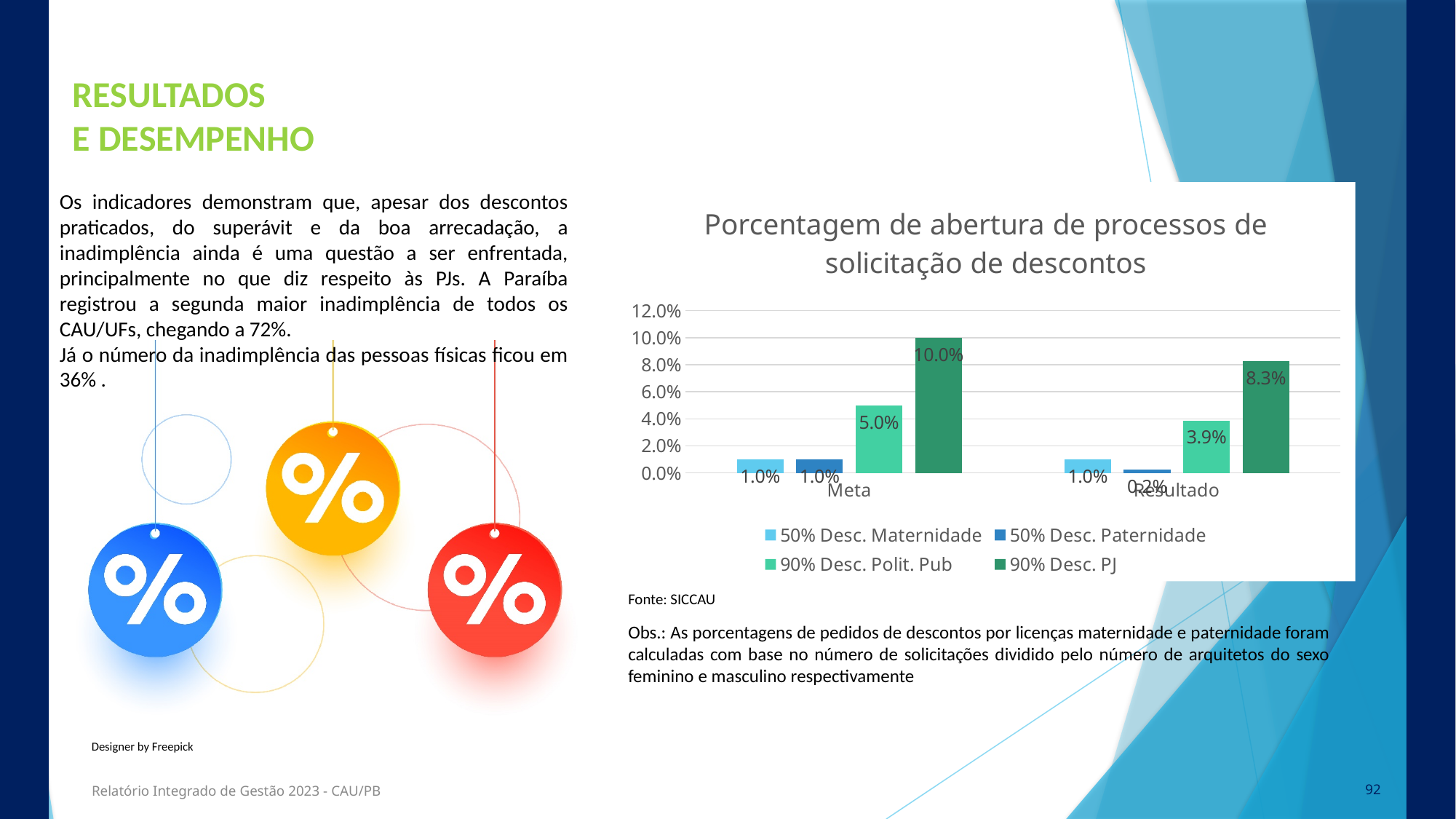
What is the value for 90% Desc. PJ in the Resultado category? 8.3% How many categories are shown on the x axis? 2 Which is larger: the 90% Desc. Polit. Pub value for Meta or for Resultado? Meta What is the difference between the Meta and Resultado values for 90% Desc. Polit. Pub? 1.1% Which series has the highest value in the Meta category? 90% Desc. PJ What is the difference between the Meta and Resultado values for 90% Desc. PJ? 1.7% What is the value for 50% Desc. Paternidade in the Resultado category? 0.2% Which series has the lowest value in the Resultado category? 50% Desc. Paternidade What is the value for 90% Desc. PJ in the Meta category? 10.0% What kind of chart is shown on the slide? Bar chart How many series does the legend list? 4 What is the value for 90% Desc. Polit. Pub in the Resultado category? 3.9%